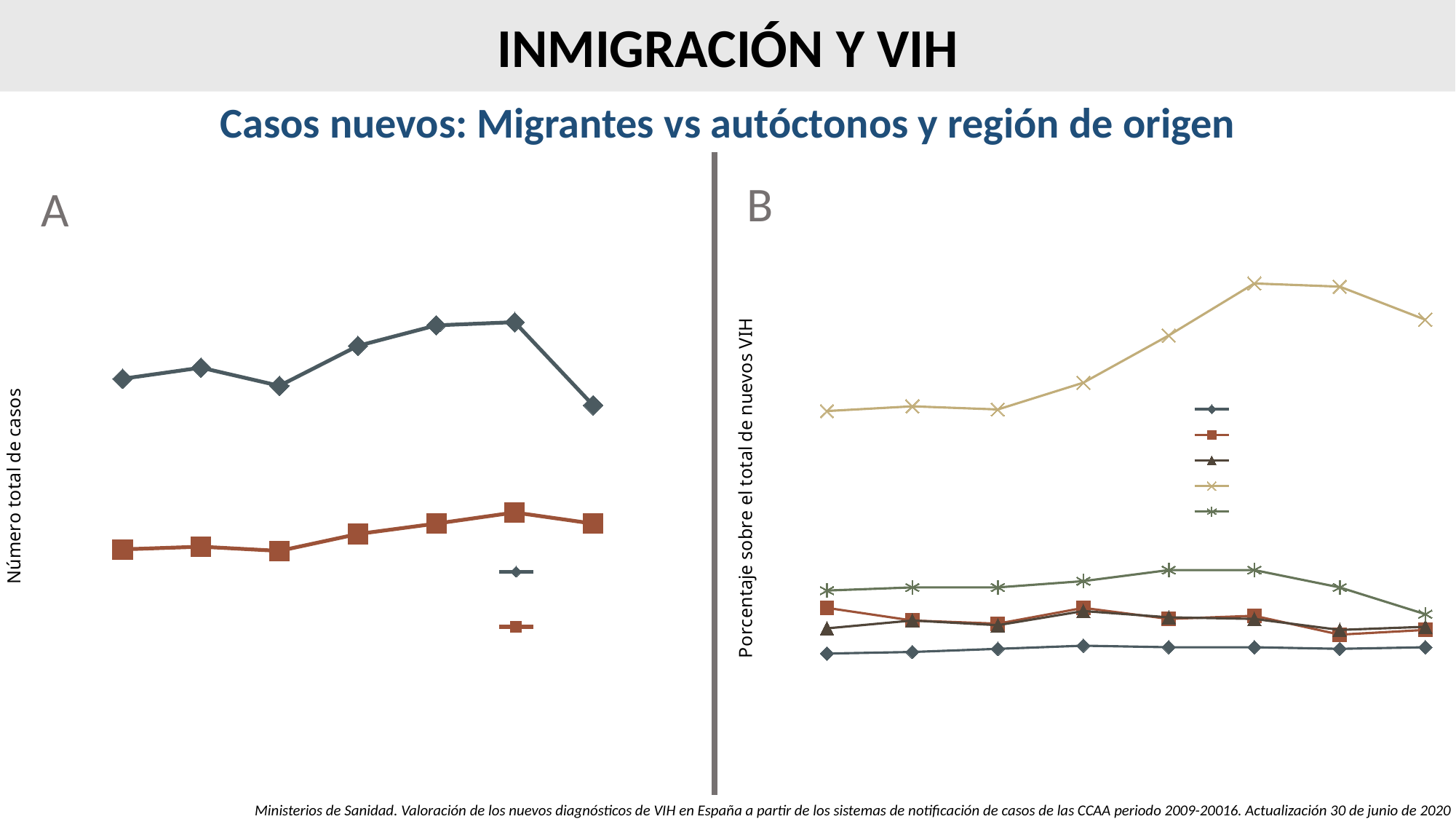
In chart B, which series has the lowest values across all points? The line with diamond markers What kind of chart is chart A on the left of the slide? Line chart In chart B, how many data points does each line have? 8 In chart A, does the diamond-marker line rise or fall between its sixth and seventh points? Fall What kind of chart is chart B on the right of the slide? Line chart In chart A, which series has the higher values throughout, the diamond-marker line or the square-marker line? The diamond-marker line What is the y-axis label of chart B? Porcentaje sobre el total de nuevos VIH In chart B, how many entries does the legend list? 5 In chart B, does the line with x markers rise or fall from its third point to its sixth point? Rise In chart A, how many entries does the legend list? 2 In chart A, how many data points does each line have? 7 In chart B, which series has the highest values across all points? The line with x markers